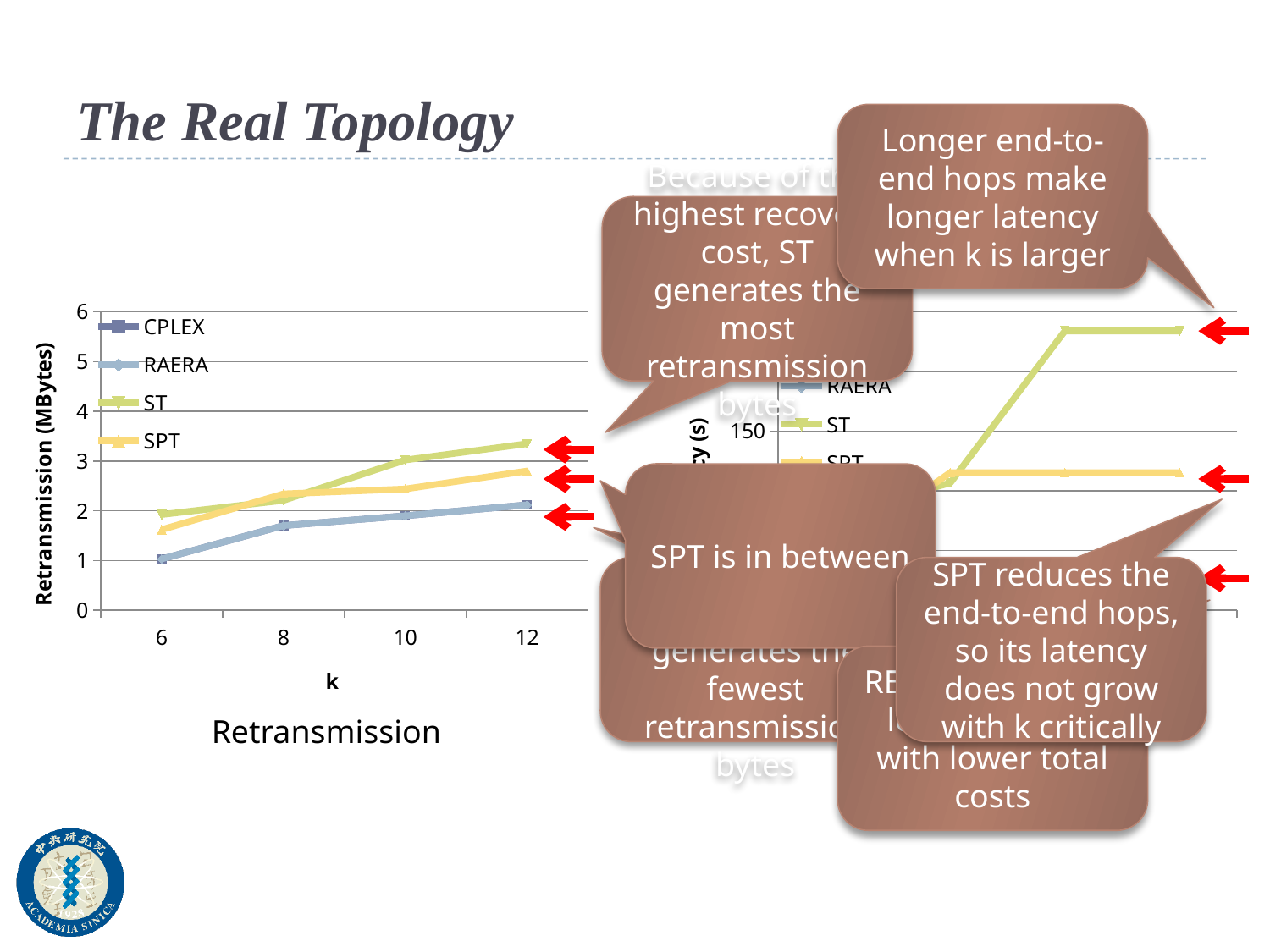
In the chart on the right, is the value for ST at its rightmost point greater or less than 150? greater What kind of chart is the Retransmission chart on the left? line chart What is the x-axis label of the Retransmission chart? k How many values of k are plotted on the x axis of the Retransmission chart? 4 In the Retransmission chart, which is larger at k = 12: ST or SPT? ST In the Retransmission chart, which series has the highest value at k = 12? ST How many series does the legend of the Retransmission chart list? 4 In the Retransmission chart, is the value for SPT at k = 6 greater or less than 2? less In the Retransmission chart, is the value for RAERA at k = 6 greater or less than 2? less In the Retransmission chart, does the ST series rise or fall as k increases? rises What is the y-axis label of the Retransmission chart? Retransmission (MBytes)